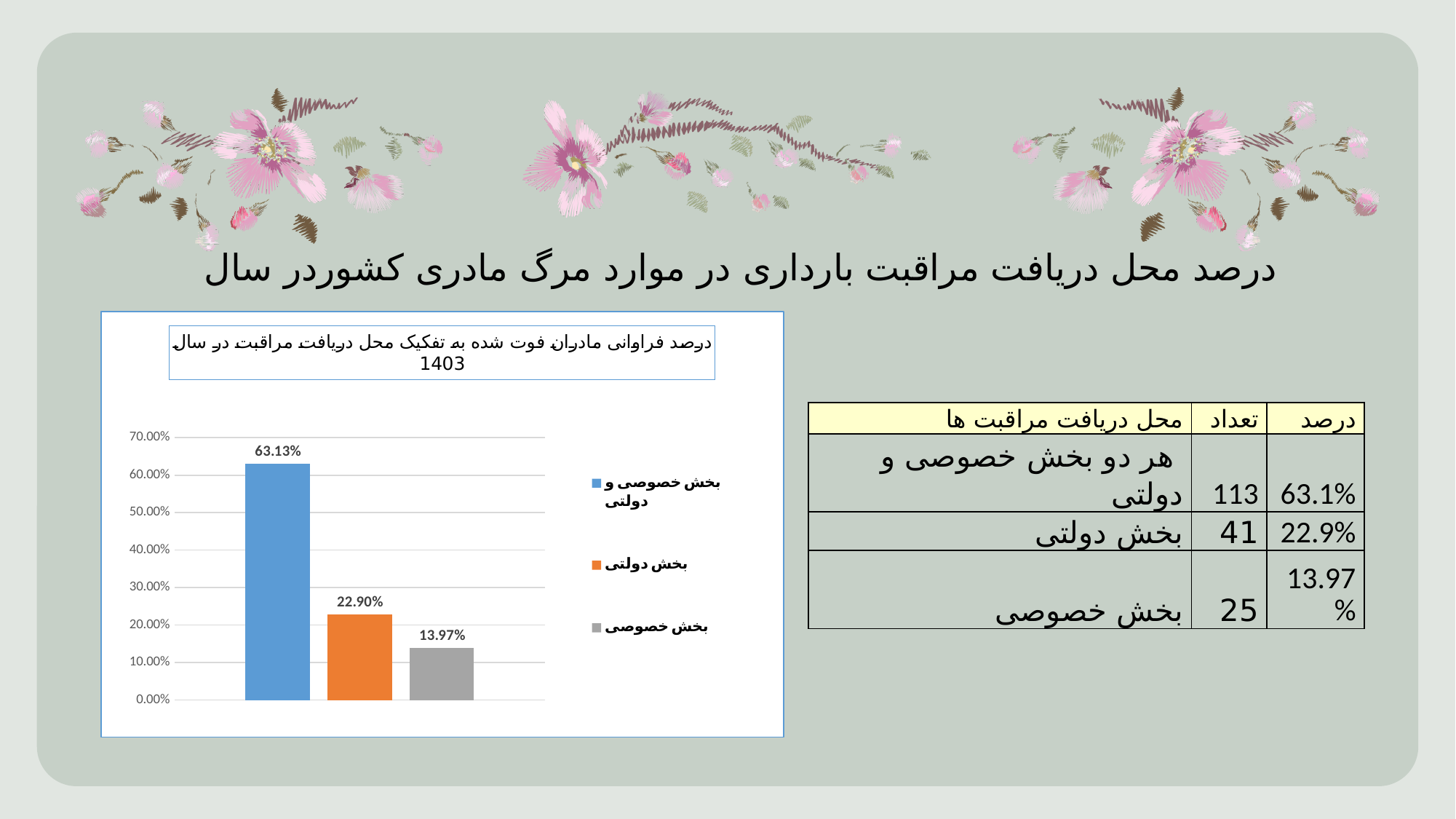
Is the value for بخش خصوصی و دولتی greater or less than 60.00%? greater What is the value shown for بخش خصوصی (private sector) in the bar chart? 13.97% Which category has the highest value in the bar chart? بخش خصوصی و دولتی What kind of chart is shown on the slide? bar chart Which is larger in the bar chart: the value for بخش دولتی or the value for بخش خصوصی? بخش دولتی How many entries does the chart legend list? 3 What is the value shown for بخش خصوصی و دولتی (both private and public sector) in the bar chart? 63.13% Which category has the lowest value in the bar chart? بخش خصوصی What is the value shown for بخش دولتی (public sector) in the bar chart? 22.90% How many bars are plotted in the chart? 3 What is the difference between the values for بخش دولتی and بخش خصوصی in the bar chart? 8.93% What is the difference between the values for بخش خصوصی و دولتی and بخش دولتی in the bar chart? 40.23%